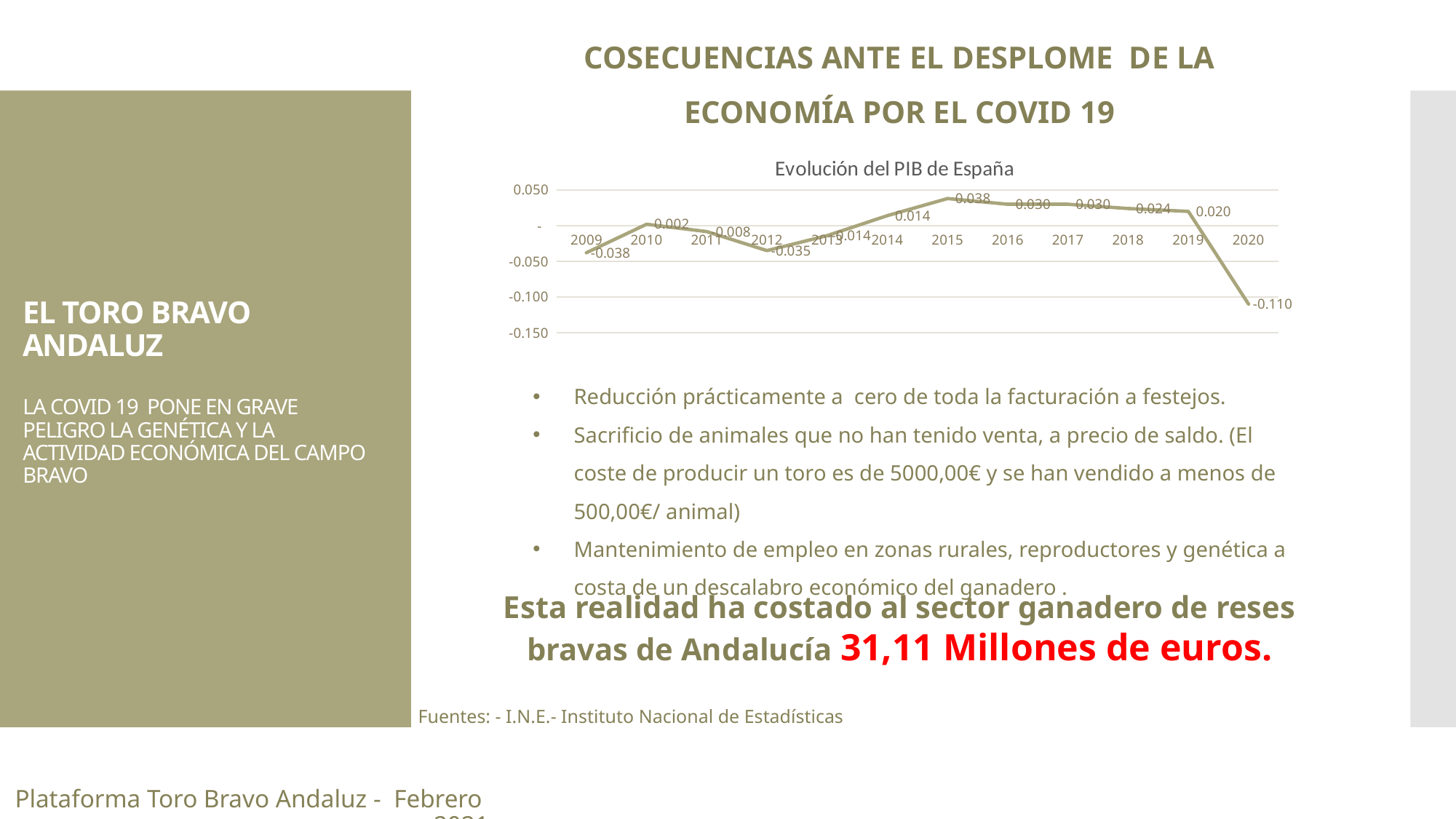
Do the values rise or fall from 2015 to 2019? fall What is the difference between the values for 2019 and 2020? 0.130 Which year has the highest value in the chart? 2015 Which year has the lowest value in the chart? 2020 How many years are plotted in the chart? 12 Which is larger, the value for 2016 or the value for 2018? 2016 What is the value for 2015 in the chart? 0.038 What is the value for 2012 in the chart? -0.035 Is the value for 2020 greater or less than -0.100? less What is the value for 2009 in the chart? -0.038 What is the value for 2020 in the 'Evolución del PIB de España' chart? -0.110 What kind of chart is shown on the slide? line chart